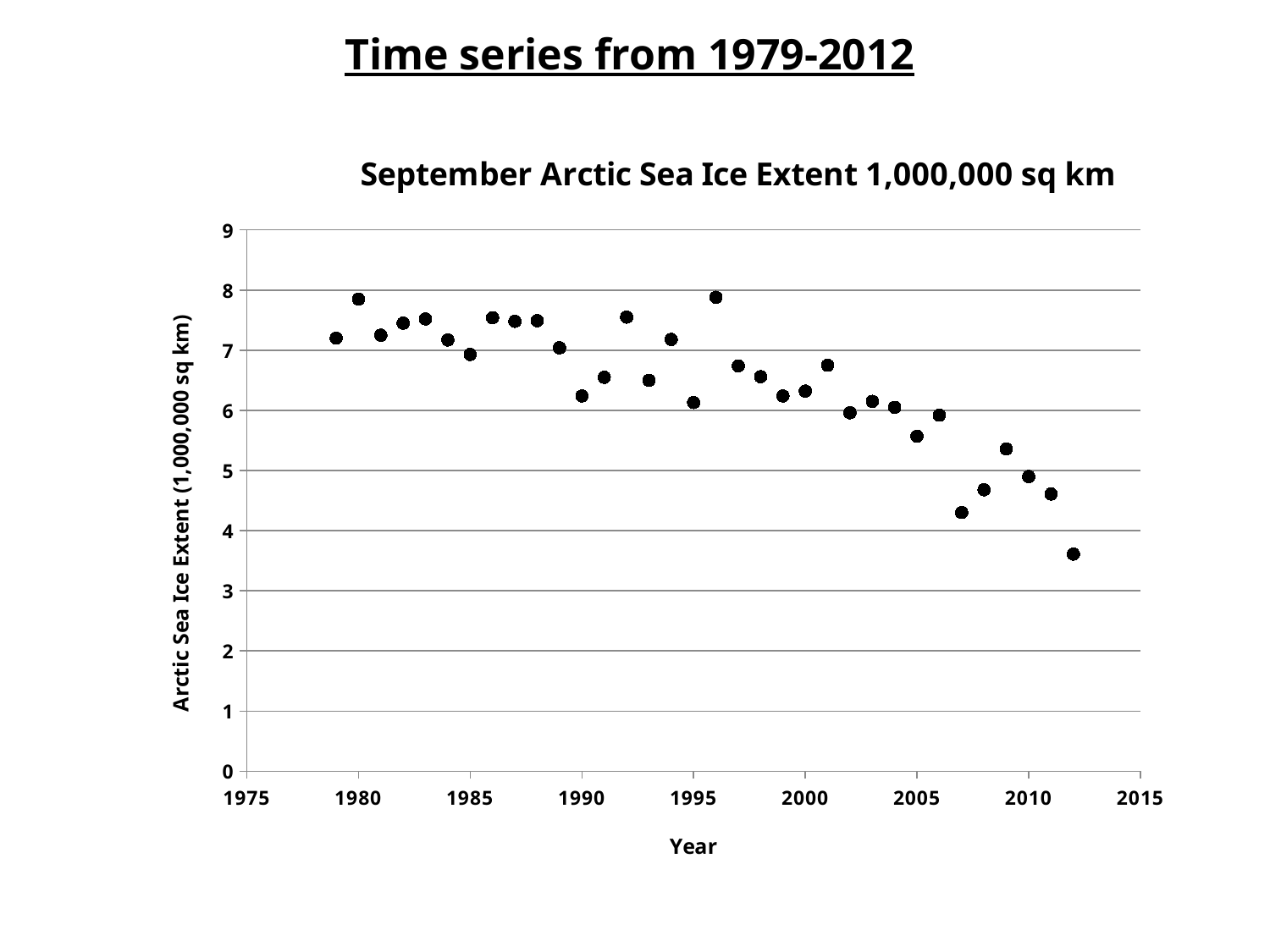
How many data points are plotted on the chart? 34 Is the value for 2007 greater or less than 5? less Is the value for 2005 greater or less than 5? greater What kind of chart is shown on the slide? scatter plot What is the title of the chart? September Arctic Sea Ice Extent 1,000,000 sq km Is the value for 1980 greater or less than 7? greater What is the label of the x axis? Year Which year has the larger sea ice extent, 2007 or 2008? 2008 Which year has the lowest September Arctic sea ice extent? 2012 Overall, do the values rise or fall from 1979 to 2012? fall Which year has the larger sea ice extent, 1979 or 2012? 1979